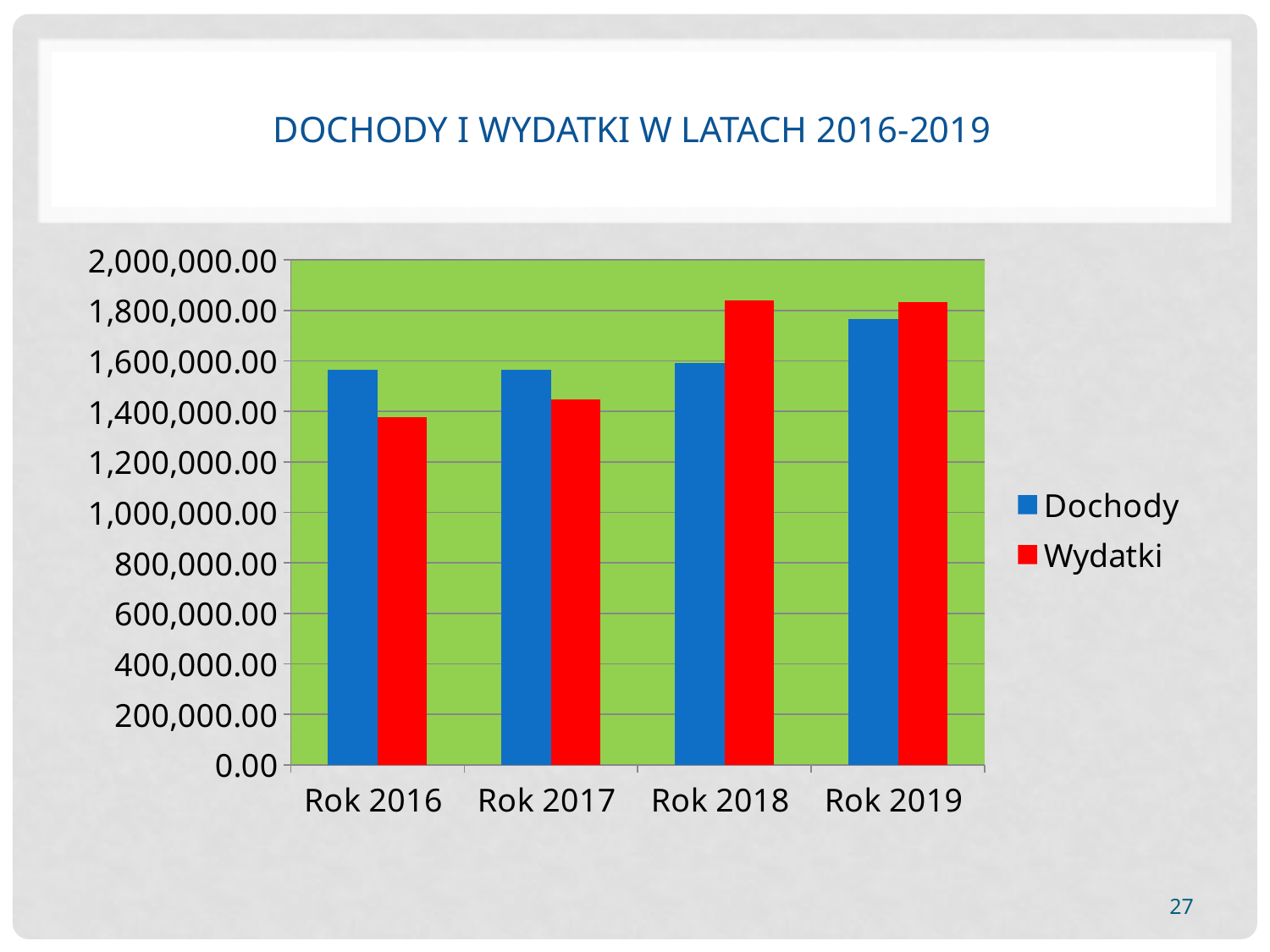
In Rok 2018, which is larger: Dochody or Wydatki? Wydatki How many year categories are shown on the x axis? 4 Is the Dochody value for Rok 2016 greater or less than 1,600,000.00? less Is the Wydatki value for Rok 2018 greater or less than 1,800,000.00? greater What is the title of the chart? DOCHODY I WYDATKI W LATACH 2016-2019 How many series does the legend list? 2 In Rok 2016, which is larger: Dochody or Wydatki? Dochody Which year has the highest Dochody value? Rok 2019 Is the Wydatki value for Rok 2016 greater or less than 1,400,000.00? less What type of chart is shown on the slide? bar chart Do the Wydatki values rise or fall from Rok 2016 to Rok 2018? rise Which year has the lowest Wydatki value? Rok 2016